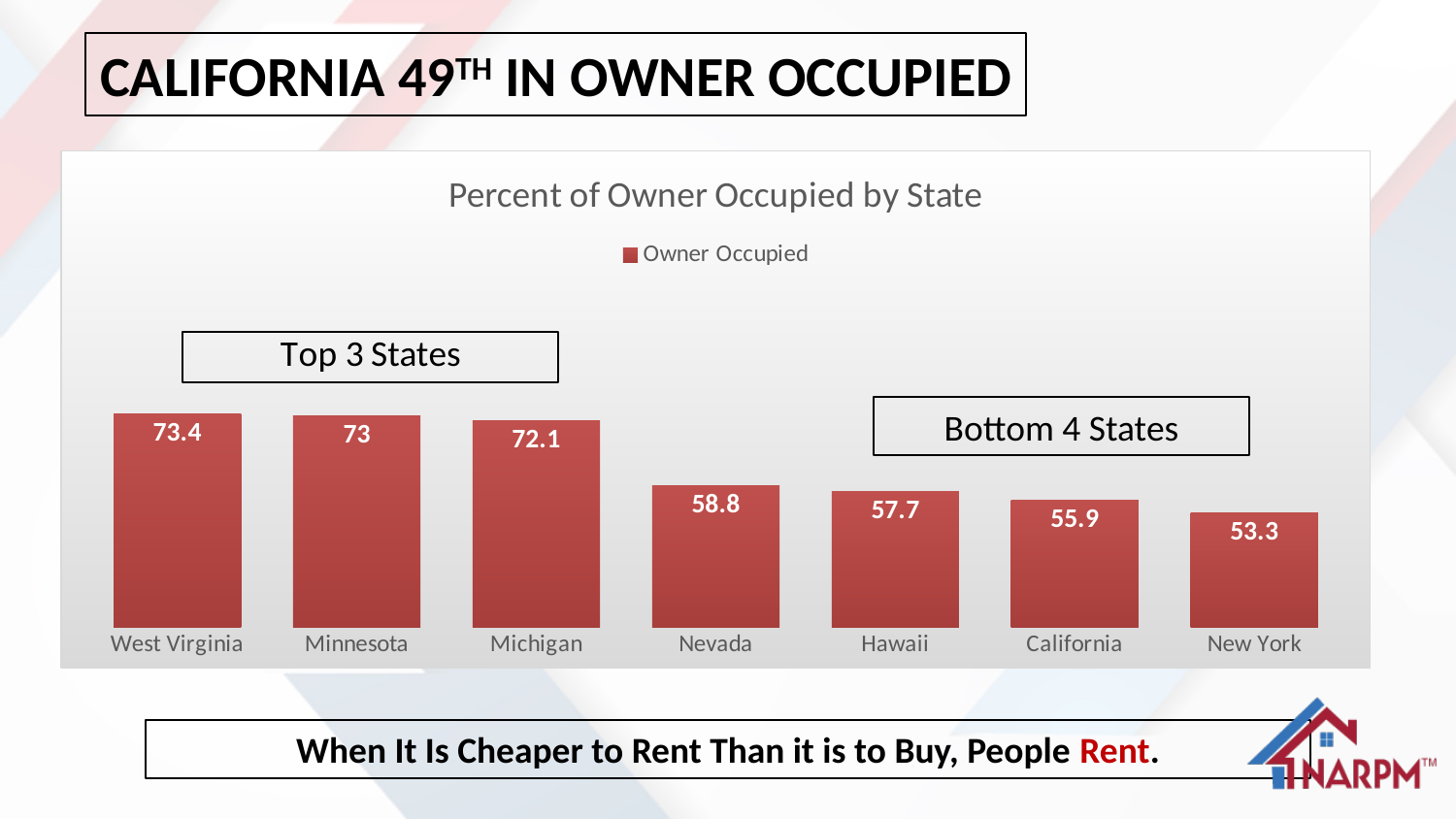
Which state has the highest value? West Virginia What is the difference between the values for Hawaii and California? 1.8 Which state has the lowest value? New York What is the value for California? 55.9 What is the difference between the values for West Virginia and New York? 20.1 How many series does the legend list? 1 Which is larger, the value for Michigan or the value for Nevada? Michigan What is the value for Nevada? 58.8 What is the value for West Virginia? 73.4 How many states are shown in the chart? 7 What is the title of the chart? Percent of Owner Occupied by State What kind of chart is shown? Bar chart